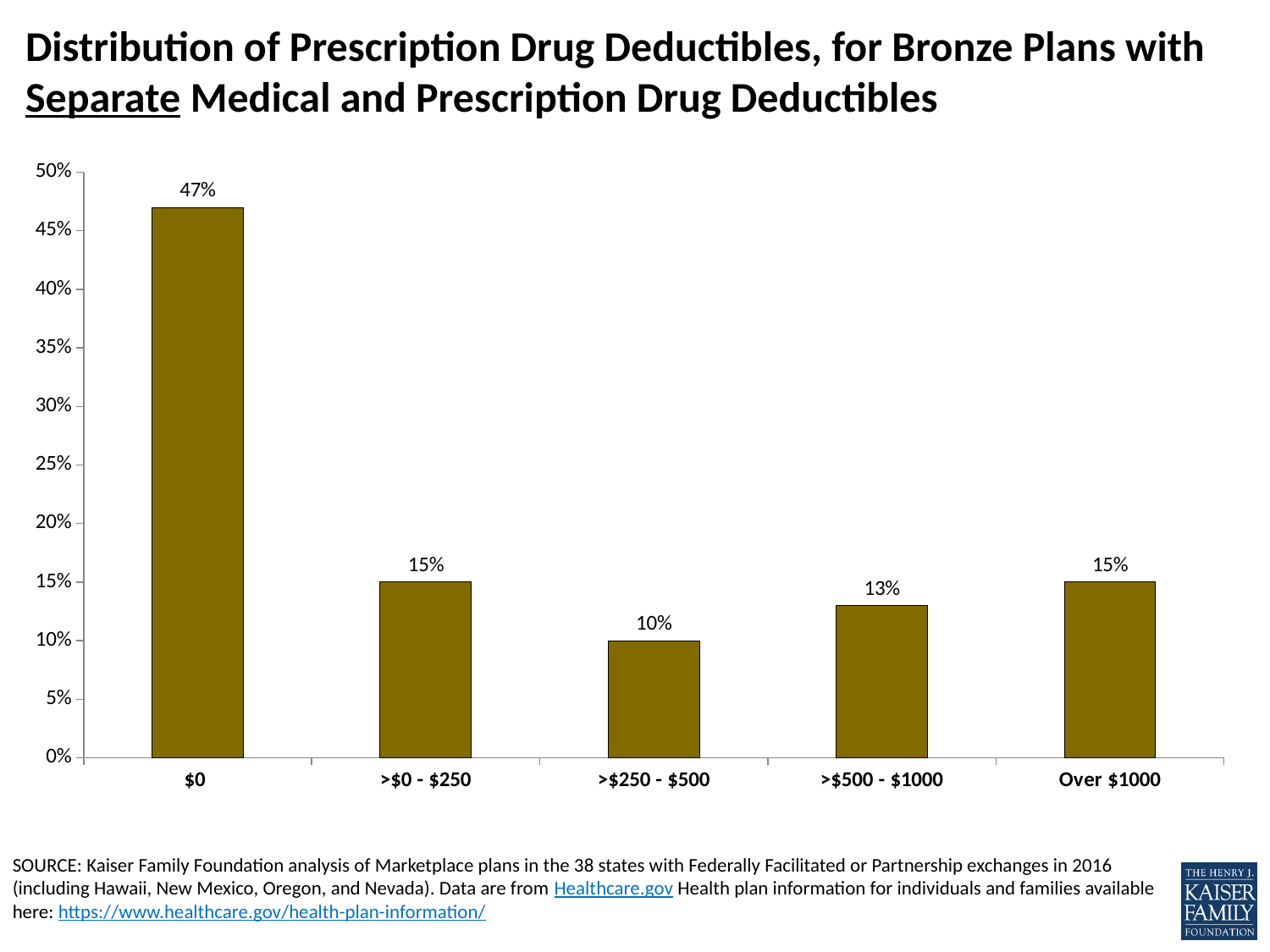
Is the value for the $0 category greater or less than 45%? greater What percentage of plans have a $0 prescription drug deductible? 47% Which deductible category has the highest share of plans? $0 Which is larger, the value for >$500 - $1000 or the value for >$250 - $500? >$500 - $1000 What is the difference between the >$500 - $1000 category and the >$250 - $500 category? 3 percentage points What is the value for the Over $1000 category? 15% How many deductible categories are shown on the x axis? 5 What is the value for the >$250 - $500 category? 10% Which deductible category has the lowest share of plans? >$250 - $500 What is the difference between the $0 category and the >$0 - $250 category? 32 percentage points What kind of chart is shown on the slide? Bar chart What is the value for the >$500 - $1000 category? 13%